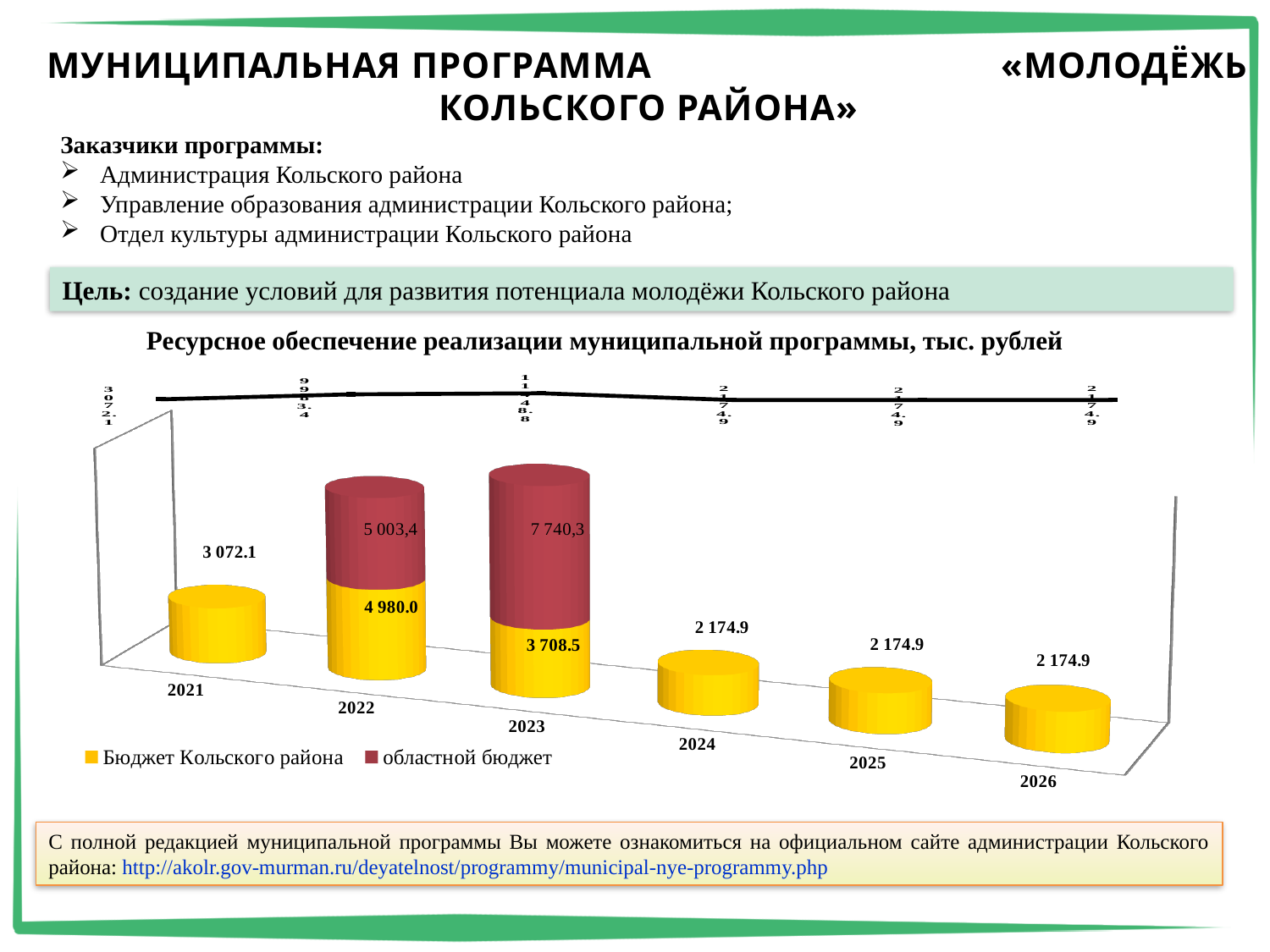
How many series does the chart legend list? 2 What is the value of Бюджет Кольского района for 2022? 4 980.0 What is the difference between областной бюджет in 2023 and in 2022? 2 736,9 What is the total of the stacked bar for 2022? 9 983.4 In which year is областной бюджет the highest? 2023 How many years are shown on the x axis of the chart? 6 What type of chart is shown on the slide? Bar chart Which year has the larger областной бюджет value, 2022 or 2023? 2023 What is the value of областной бюджет for 2023? 7 740,3 What is the value of Бюджет Кольского района for 2021? 3 072.1 What is the value of Бюджет Кольского района for 2025? 2 174.9 What is the difference between Бюджет Кольского района in 2022 and in 2023? 1 271.5